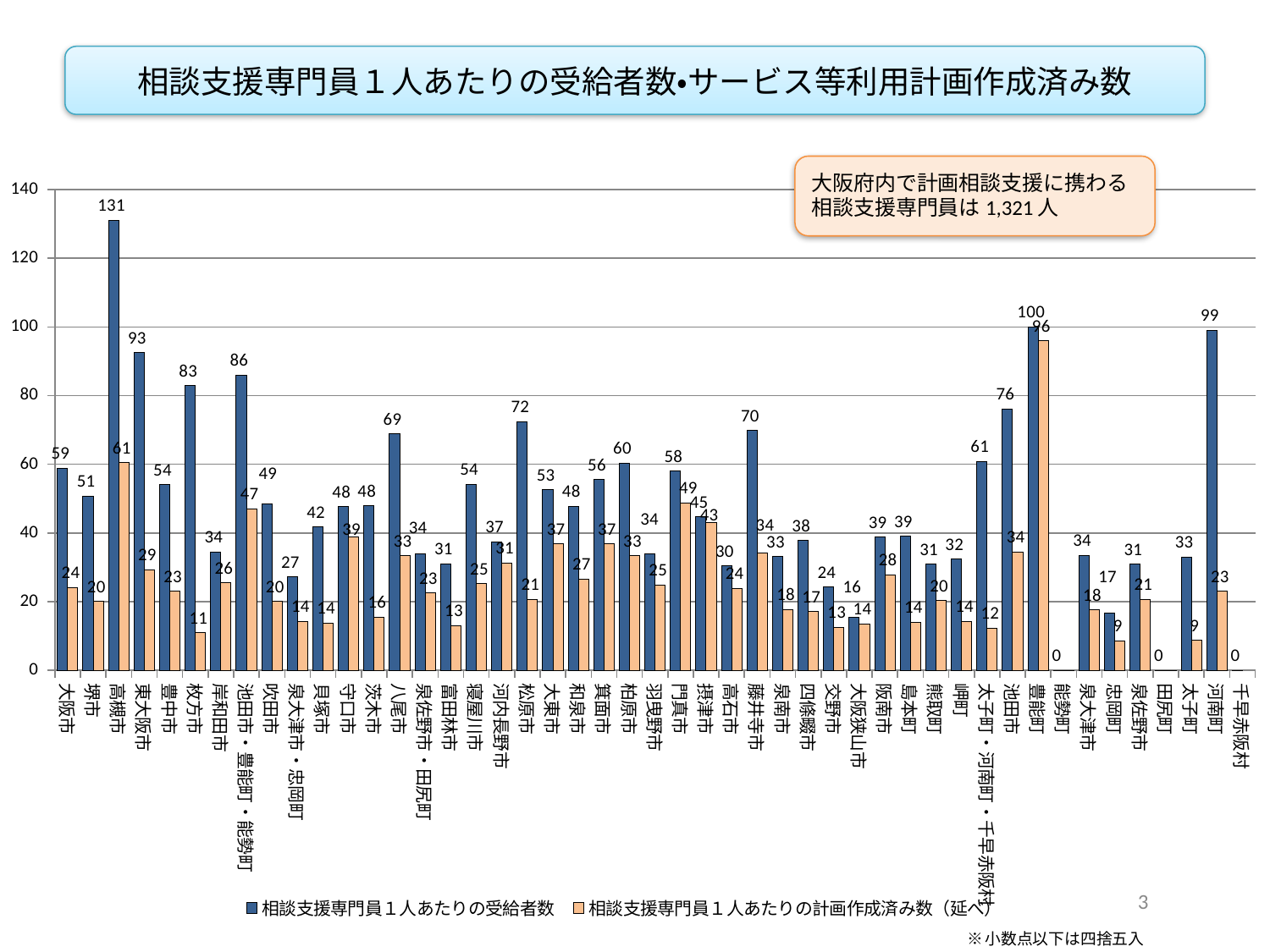
What is the value of 相談支援専門員１人あたりの計画作成済み数（延べ） for 門真市? 49 How many series does the legend list? 2 Which category has the highest value of 相談支援専門員１人あたりの受給者数? 高槻市 What is the value of 相談支援専門員１人あたりの計画作成済み数（延べ） for 豊能町? 96 What is the value of 相談支援専門員１人あたりの受給者数 for 河南町? 99 What is the difference between 相談支援専門員１人あたりの受給者数 and 相談支援専門員１人あたりの計画作成済み数（延べ） for 高槻市? 70 What type of chart is shown on the slide? bar chart Which is larger: 相談支援専門員１人あたりの受給者数 for 枚方市 or for 池田市? 枚方市 What is the title of the chart? 相談支援専門員１人あたりの受給者数•サービス等利用計画作成済み数 What is the value of 相談支援専門員１人あたりの受給者数 for 高槻市? 131 Is the value of 相談支援専門員１人あたりの受給者数 for 東大阪市 greater or less than 80? greater What is the value of 相談支援専門員１人あたりの受給者数 for 枚方市? 83